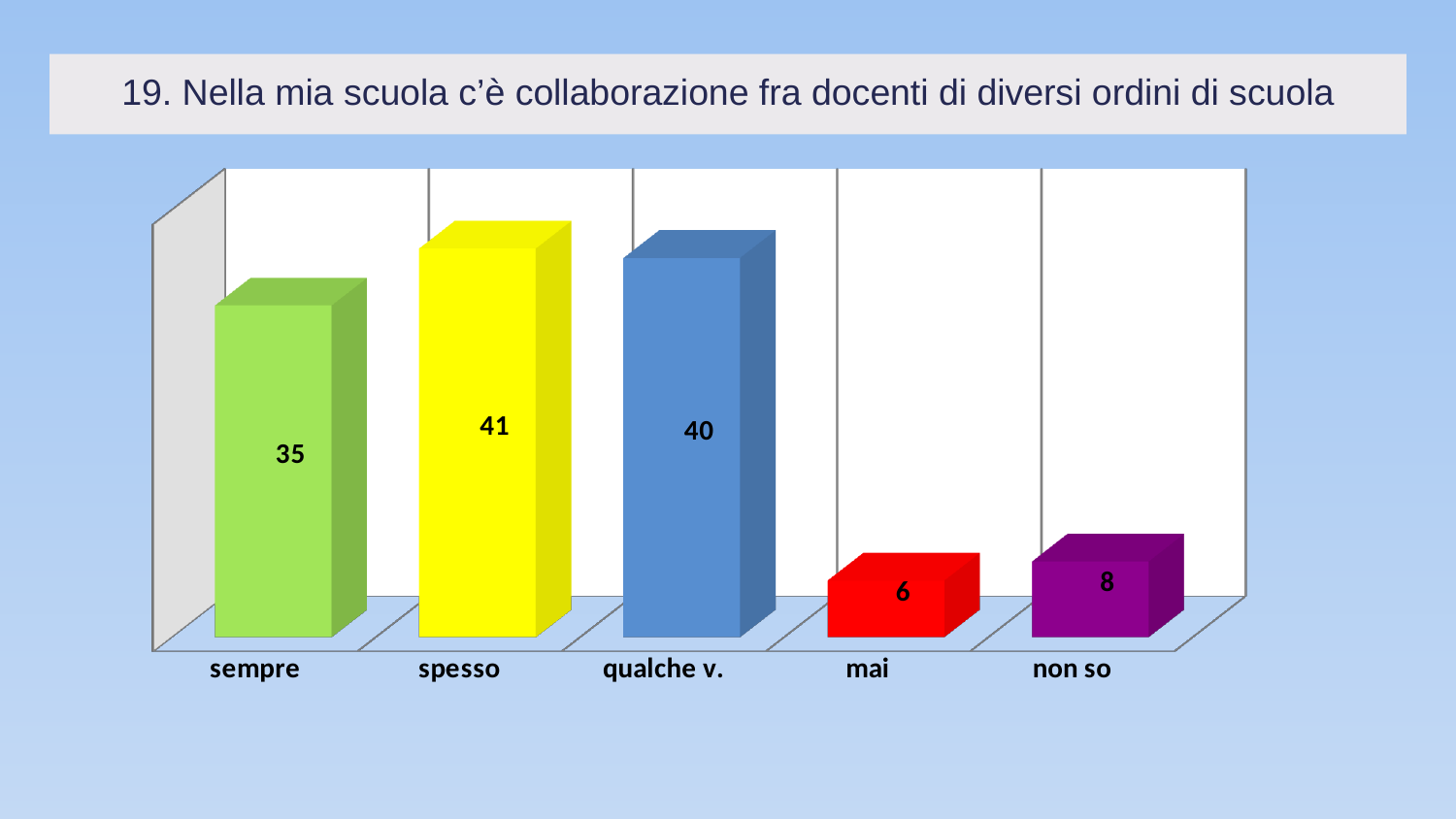
What is the difference between the values for "spesso" and "sempre"? 6 Which category has the lowest value? mai What is the value for "spesso"? 41 How many categories are shown on the x axis? 5 What is the value for "qualche v."? 40 What is the value for "sempre"? 35 What is the value for "mai"? 6 Which is larger, the value for "non so" or the value for "mai"? non so What colour is the bar for "qualche v."? blue What is the value for "non so"? 8 What kind of chart is shown on the slide? bar chart Which category has the highest value? spesso